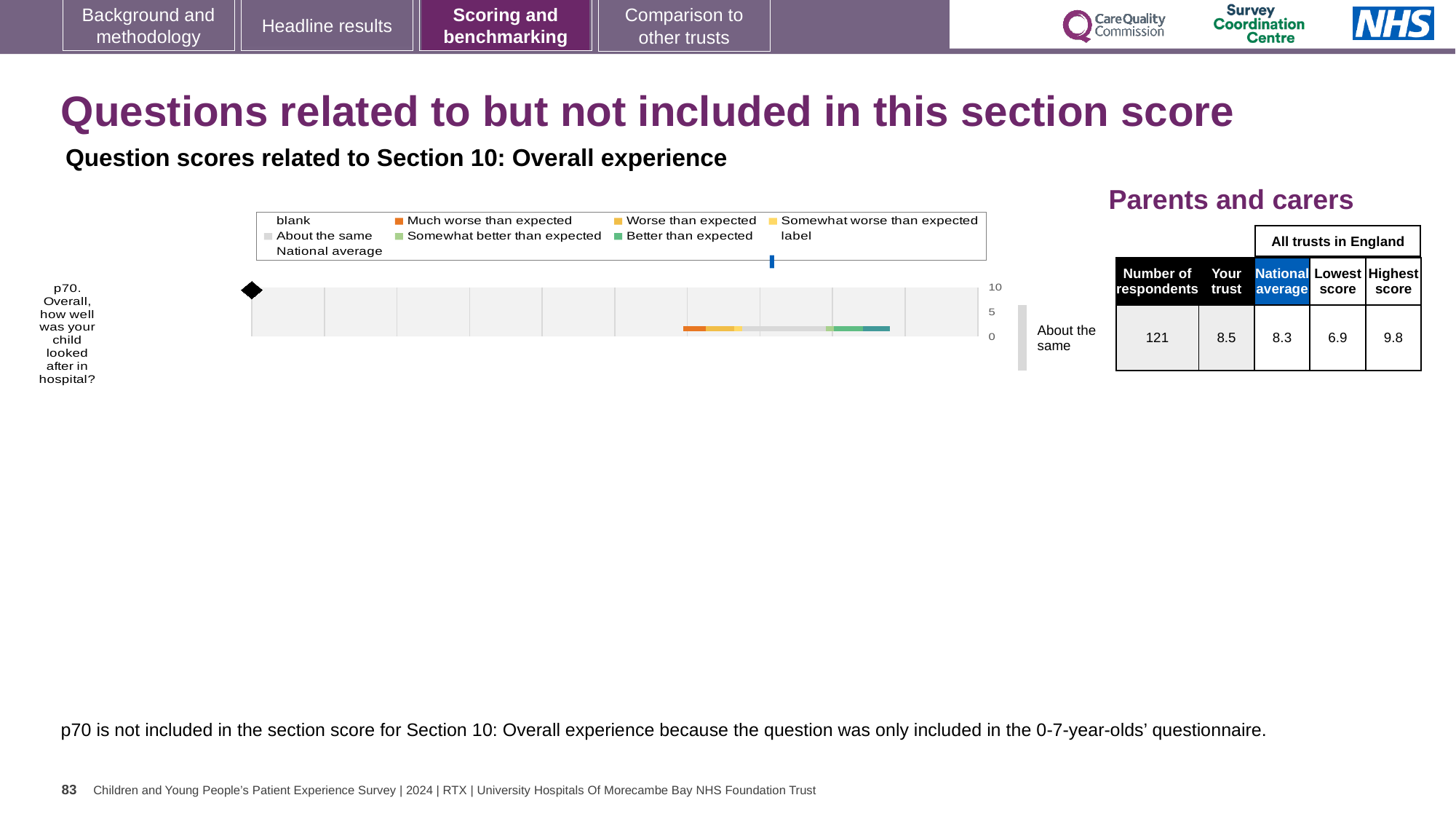
In the Parents and carers table, what is the difference between the highest score and the lowest score for p70? 2.9 In the Parents and carers table, what is the national average score for p70? 8.3 In the Parents and carers table, how many respondents answered p70? 121 What is the highest tick value shown on the chart's score axis? 10 In the Parents and carers table, what is the lowest score among all trusts in England for p70? 6.9 What label appears to the right of the bar for p70 in the chart? About the same In the Parents and carers table, which is larger for p70: the 'Your trust' score or the national average? Your trust What colour represents 'Much worse than expected' in the chart legend? orange What kind of chart is shown on the slide? bar chart How many entries does the chart legend list? 9 In the Parents and carers table, what is the 'Your trust' score for p70? 8.5 How many questions are plotted as bars in the chart? 1